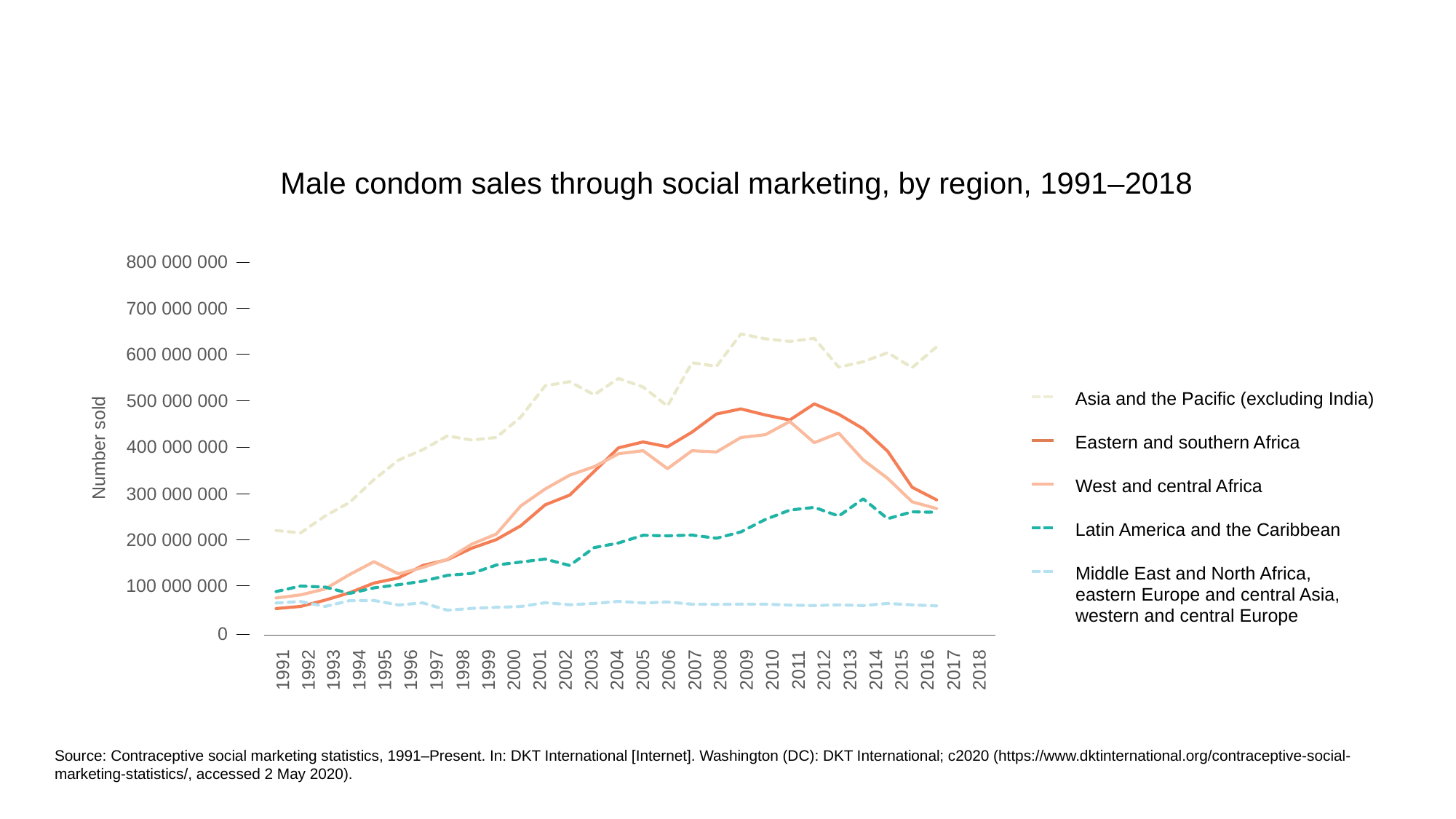
Which region has the lowest number sold in 2009? Middle East and North Africa, eastern Europe and central Asia, western and central Europe In 2009, which is larger: Eastern and southern Africa or West and central Africa? Eastern and southern Africa Do the values for Asia and the Pacific (excluding India) rise or fall from 1991 to 2009? rise Is the value for Latin America and the Caribbean in 2013 greater or less than 200 000 000? greater What is the label of the y axis? Number sold Is the value for Asia and the Pacific (excluding India) in 2009 greater or less than 600 000 000? greater How many series does the legend list? 5 How many years are labelled on the x axis? 28 Which region has the highest number sold in 2009? Asia and the Pacific (excluding India) What kind of chart is shown on the slide? line chart Is the value for Eastern and southern Africa in 2011 greater or less than 400 000 000? greater